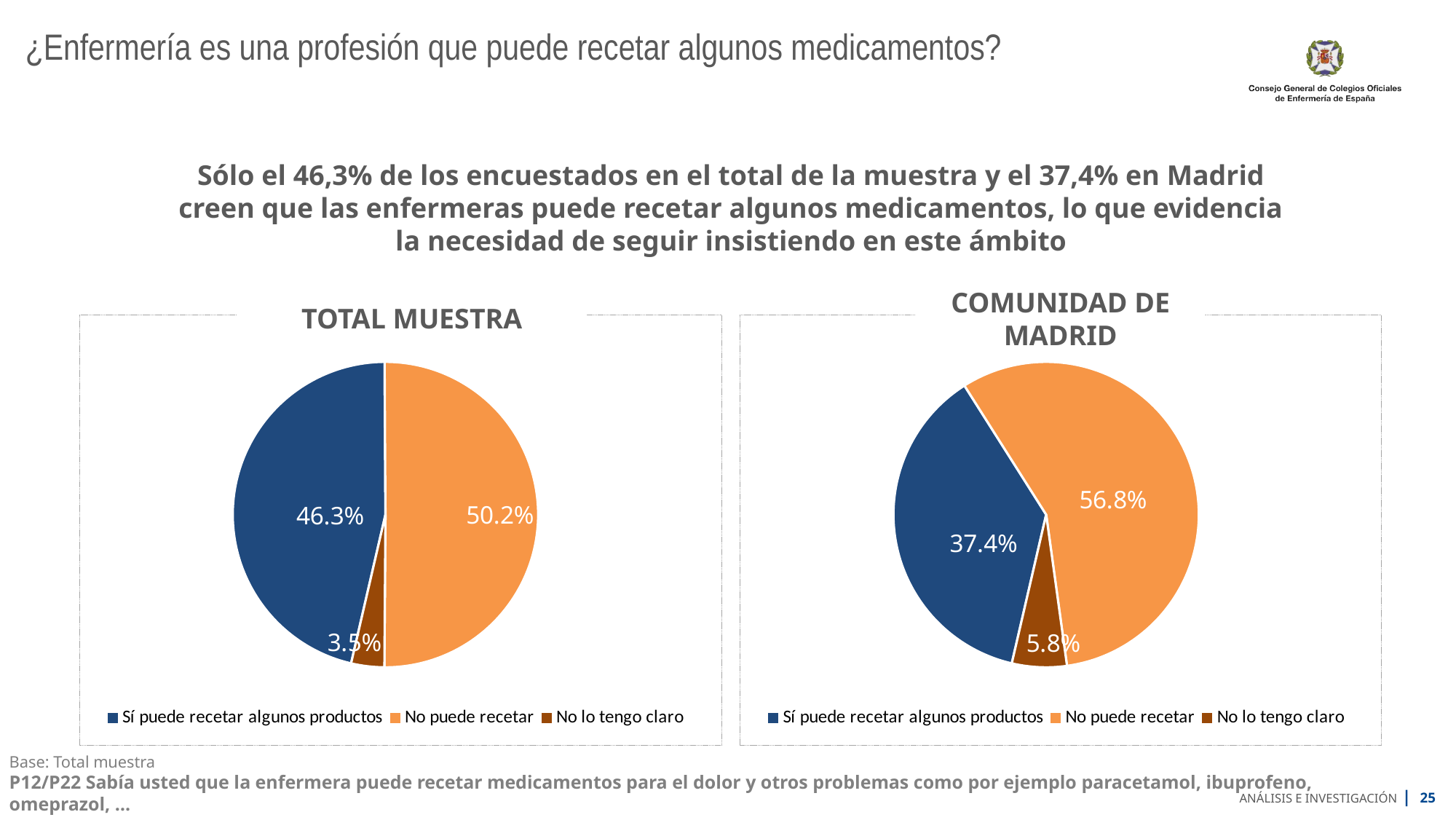
In the COMUNIDAD DE MADRID chart, what percentage corresponds to 'No puede recetar'? 56.8% In the COMUNIDAD DE MADRID chart, what percentage corresponds to 'No lo tengo claro'? 5.8% How many categories does the legend of the COMUNIDAD DE MADRID chart list? 3 In the TOTAL MUESTRA chart, what percentage corresponds to 'Sí puede recetar algunos productos'? 46.3% In the COMUNIDAD DE MADRID chart, which category has the largest slice? No puede recetar What type of chart is the TOTAL MUESTRA chart? Pie chart Which is larger: 'No lo tengo claro' in the TOTAL MUESTRA chart or 'No lo tengo claro' in the COMUNIDAD DE MADRID chart? COMUNIDAD DE MADRID In the COMUNIDAD DE MADRID chart, what percentage corresponds to 'Sí puede recetar algunos productos'? 37.4% In the COMUNIDAD DE MADRID chart, what is the difference between 'No puede recetar' and 'Sí puede recetar algunos productos'? 19.4 percentage points In the TOTAL MUESTRA chart, which category has the smallest slice? No lo tengo claro In the TOTAL MUESTRA chart, what percentage corresponds to 'No puede recetar'? 50.2% In the TOTAL MUESTRA chart, what percentage corresponds to 'No lo tengo claro'? 3.5%